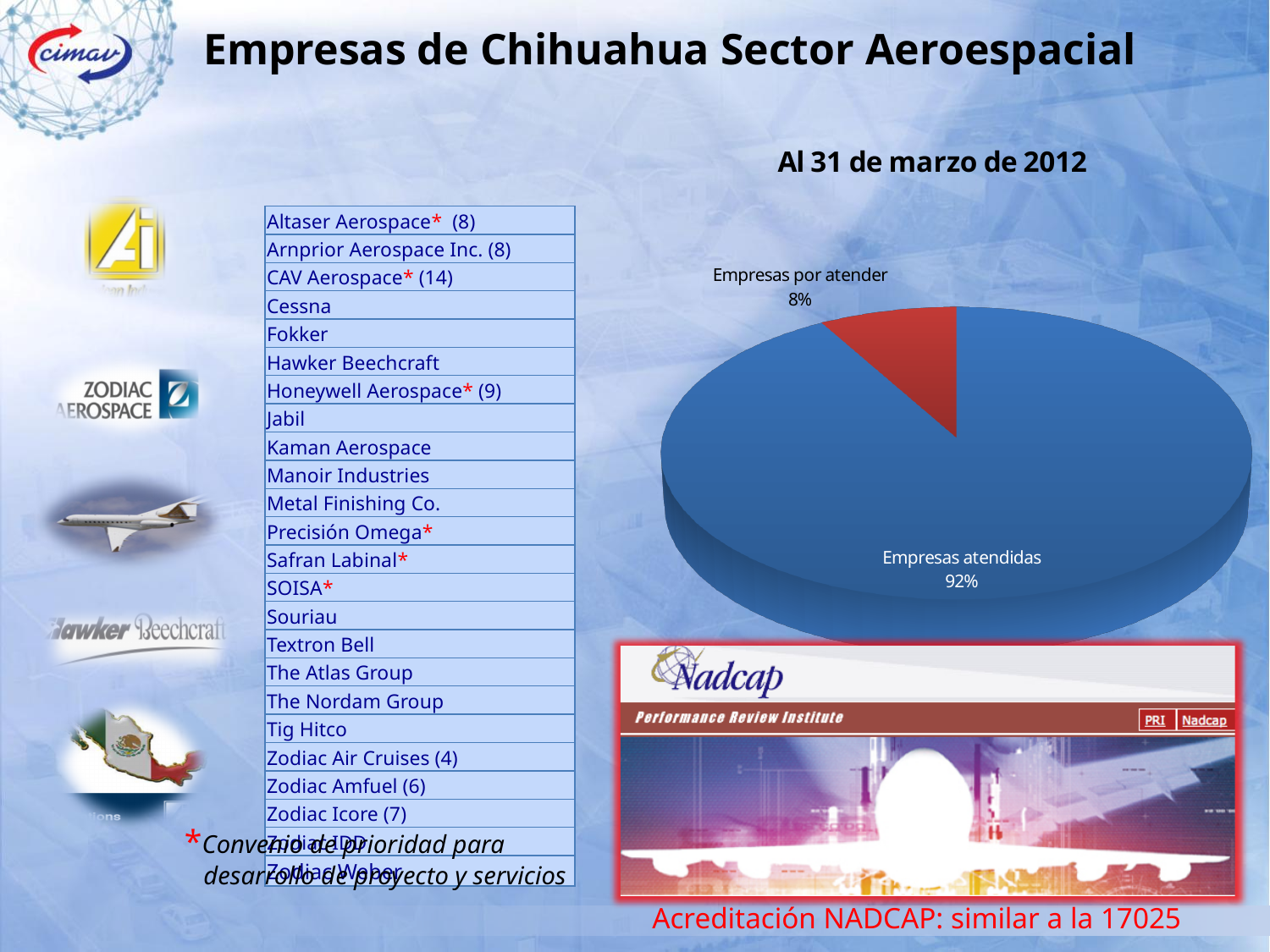
Which slice of the pie chart is the largest? Empresas atendidas What share of the pie chart is labelled "Empresas por atender"? 8% What is the difference in percentage points between the "Empresas atendidas" slice and the "Empresas por atender" slice? 84 What colour is the "Empresas por atender" slice of the pie chart? Red What kind of chart is shown on the slide? Pie chart Is the share for "Empresas por atender" in the pie chart greater or less than 10%? less Which is larger in the pie chart: "Empresas atendidas" or "Empresas por atender"? Empresas atendidas How many slices does the pie chart have? 2 What share of the pie chart is labelled "Empresas atendidas"? 92% Is the share for "Empresas atendidas" in the pie chart greater or less than 50%? greater Which slice of the pie chart is the smallest? Empresas por atender What colour is the "Empresas atendidas" slice of the pie chart? Blue